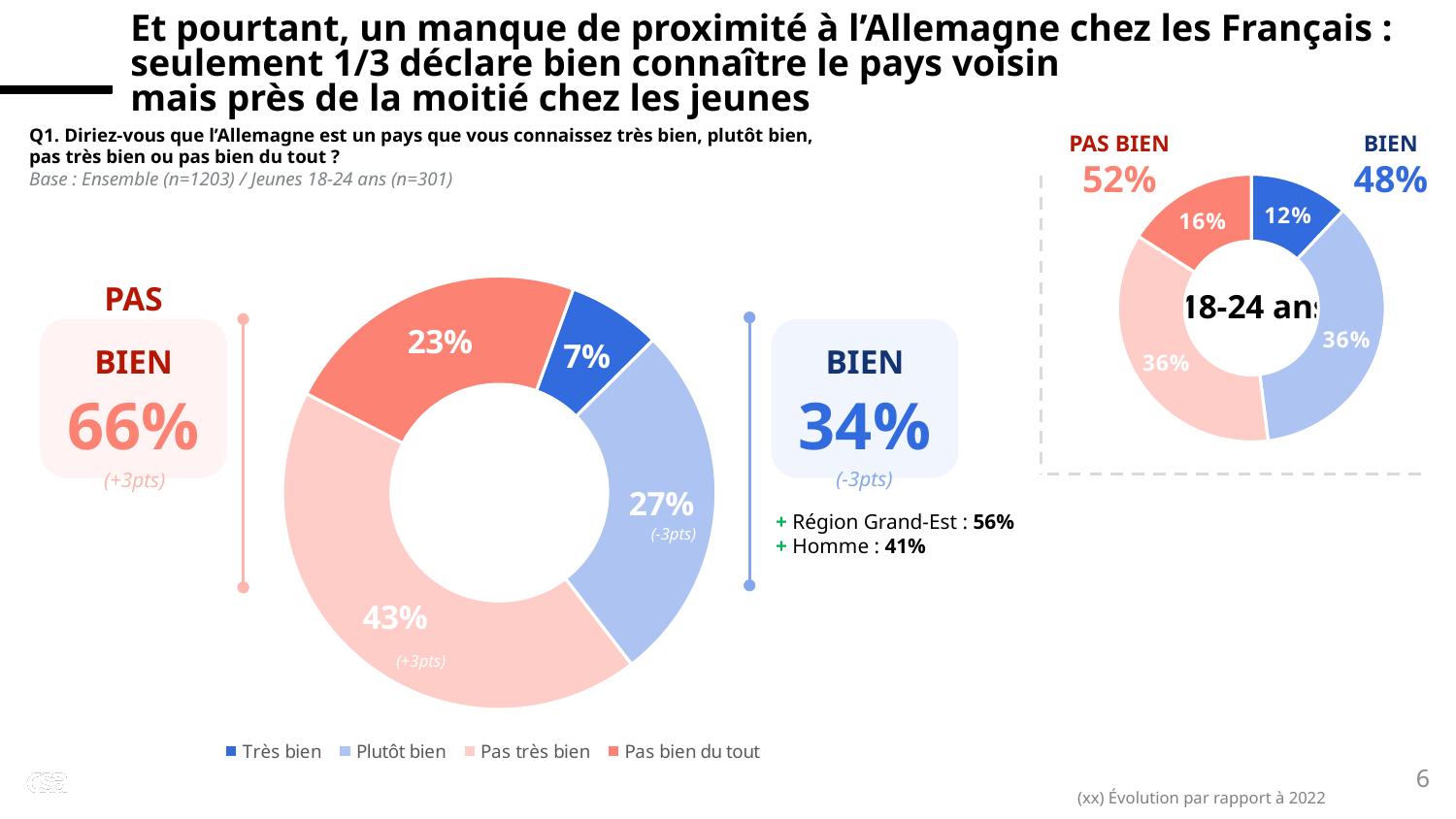
In the large donut chart (Ensemble), what share of respondents answered "Très bien"? 7% What type of chart is used on this slide? Donut (pie) chart In the large donut chart (Ensemble), what is the difference between the "Pas très bien" share and the "Pas bien du tout" share? 20 points In the large donut chart (Ensemble), what is the combined share of "Très bien" and "Plutôt bien" (the BIEN total)? 34% In the large donut chart (Ensemble), what share of respondents answered "Pas très bien"? 43% How many response categories does the legend list? 4 In the large donut chart (Ensemble), what share of respondents answered "Plutôt bien"? 27% In the large donut chart (Ensemble), which response category has the largest share? Pas très bien In the small donut chart (18-24 ans), what share of respondents answered "Très bien"? 12% In the large donut chart (Ensemble), which response category has the smallest share? Très bien In the small donut chart (18-24 ans), which is larger: the "Plutôt bien" share or the "Pas bien du tout" share? Plutôt bien In the small donut chart (18-24 ans), what share of respondents answered "Pas bien du tout"? 16%